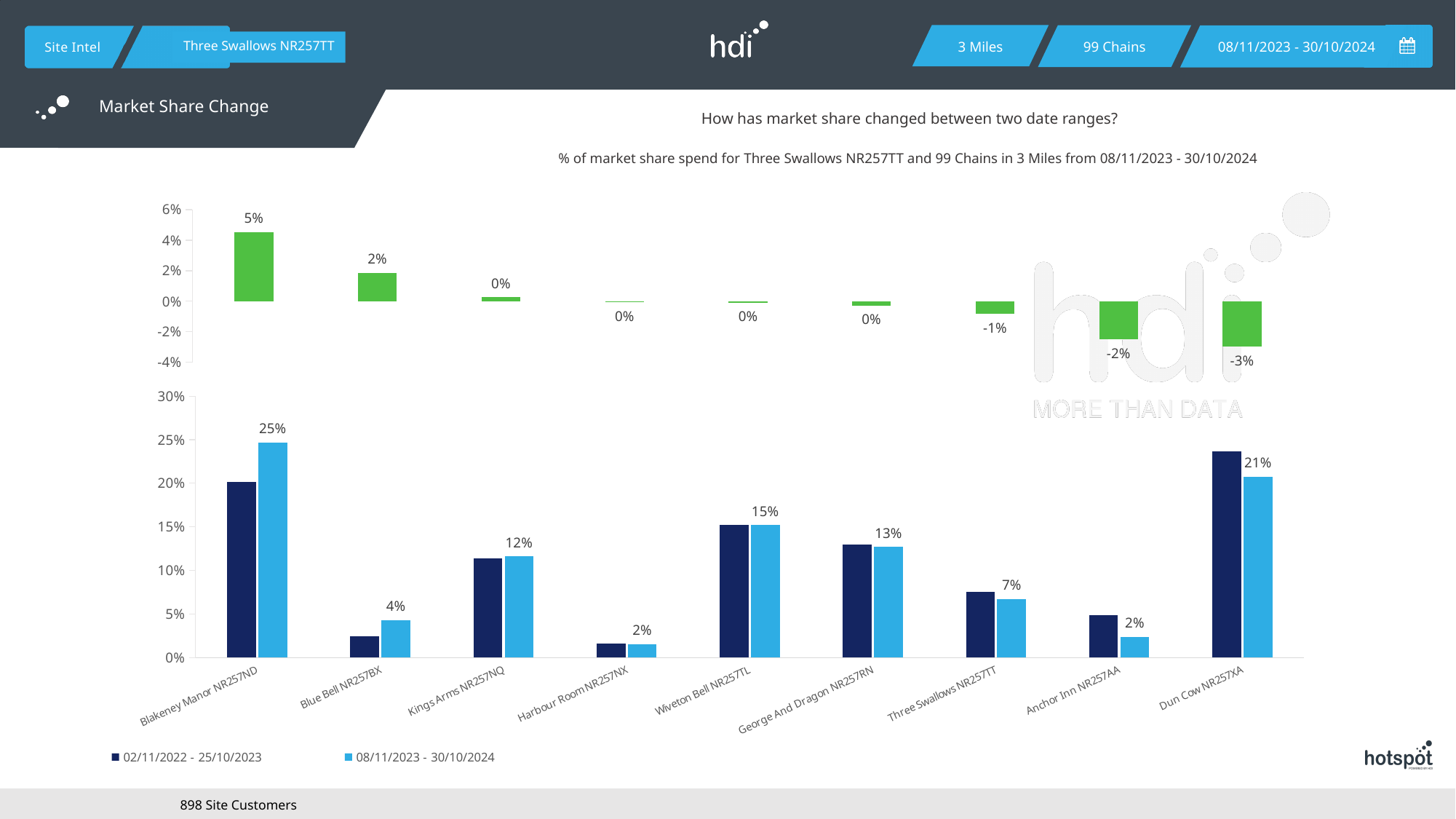
In the bottom chart, what is the difference between the 08/11/2023 - 30/10/2024 values for Blakeney Manor NR257ND and Dun Cow NR257XA? 4% How many categories are shown on the x axis of the bottom chart? 9 In the bottom chart, what is the value for Blakeney Manor NR257ND in the 08/11/2023 - 30/10/2024 series? 25% In the top chart, what is the market share change for Dun Cow NR257XA? -3% In the top chart, what is the market share change for Blakeney Manor NR257ND? 5% How many series does the legend of the bottom chart list? 2 In the bottom chart, what is the value for Three Swallows NR257TT in the 08/11/2023 - 30/10/2024 series? 7% In the bottom chart, is the 02/11/2022 - 25/10/2023 value for Dun Cow NR257XA greater or less than 20%? greater In the top chart, which category has the highest market share change? Blakeney Manor NR257ND What type of chart is the bottom chart? Bar chart In the top chart, which category has the lowest market share change? Dun Cow NR257XA In the bottom chart, which is larger for the 08/11/2023 - 30/10/2024 series: Wiveton Bell NR257TL or George And Dragon NR257RN? Wiveton Bell NR257TL